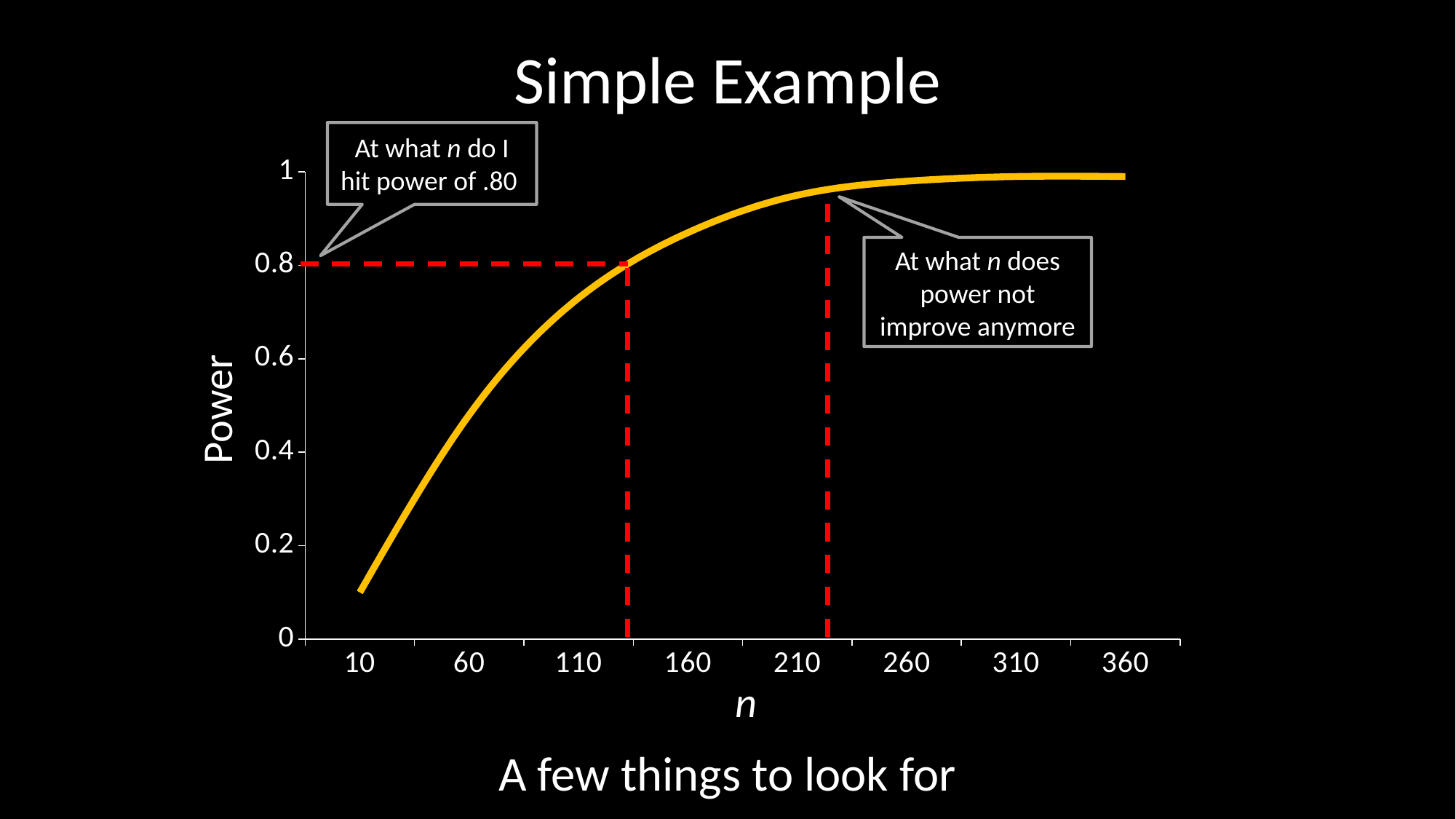
Does power rise or fall as n increases along the x axis? rises How many tick labels are shown on the x axis? 8 What kind of chart is shown on the slide? line chart Is the power value at n = 160 greater or less than 0.8? greater What is the title of the chart on the slide? Simple Example What power level does the horizontal red dashed line mark? 0.8 How many lines (data series) are plotted on the chart? 1 Is the power value at n = 60 greater or less than 0.6? less Is the power value at n = 260 greater or less than 0.8? greater What is the label of the y axis? Power